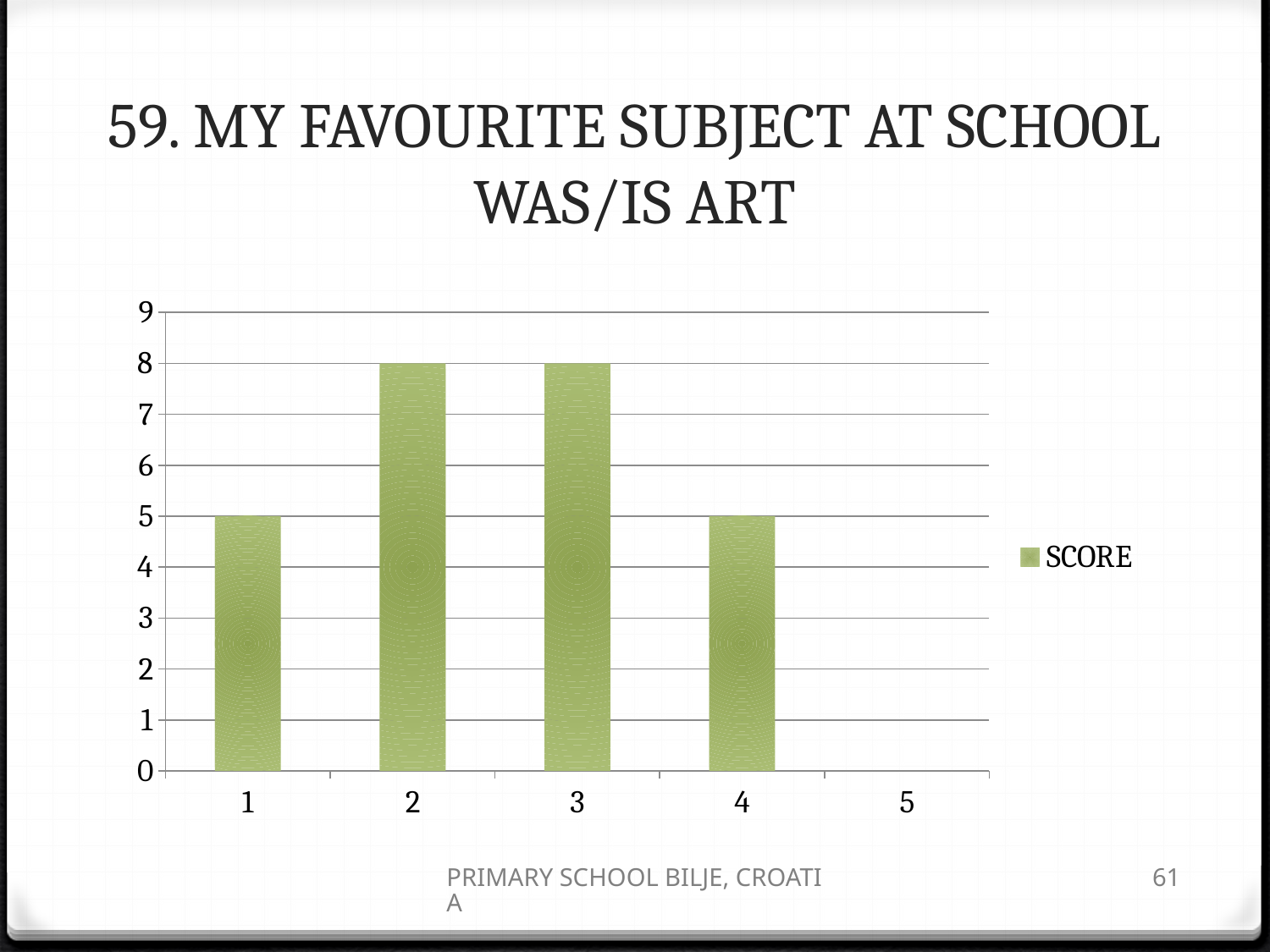
What is the value for category 2? 8 What is the value for category 3? 8 How many categories are shown on the x axis? 5 How many series does the legend list? 1 What is the difference between the values for category 2 and category 1? 3 Which is larger, the value for category 3 or the value for category 4? category 3 What kind of chart is shown on the slide? bar chart What is the name of the series shown in the legend? SCORE What is the value for category 4? 5 What is the value for category 1? 5 Is the value for category 2 greater or less than 6? greater Which categories share the highest value on the chart? 2 and 3